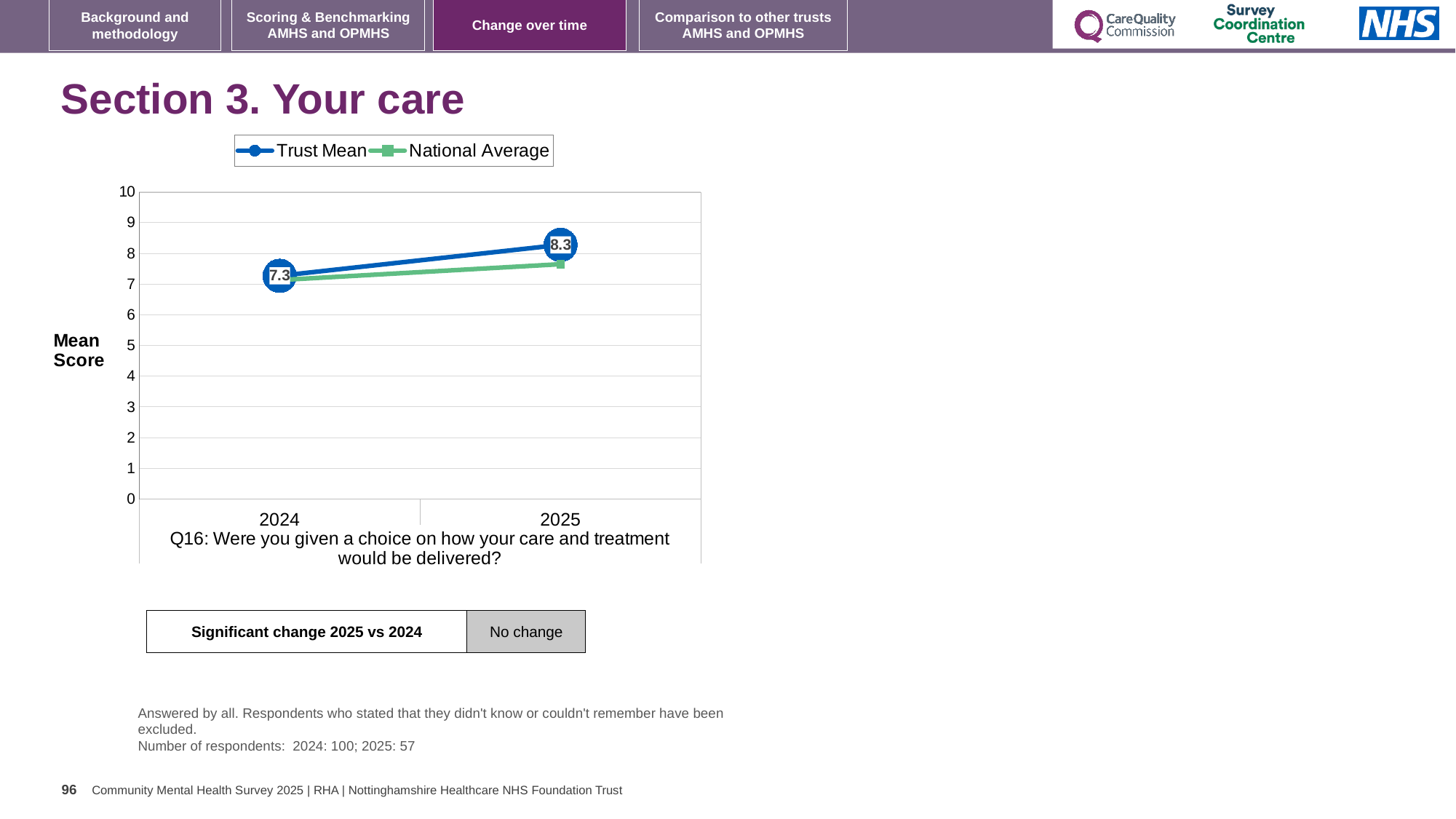
How many series does the legend list? 2 What is the label on the vertical axis of the chart? Mean Score What is the Trust Mean score for 2024? 7.3 How many years are plotted on the x axis? 2 Is the National Average value for 2025 greater or less than 7? greater Which year has the higher Trust Mean score, 2024 or 2025? 2025 What is the Trust Mean score for 2025? 8.3 Does the Trust Mean line rise or fall from 2024 to 2025? rises By how much did the Trust Mean score change from 2024 to 2025? 1.0 Is the National Average value for 2024 greater or less than 8? less What kind of chart is shown on the slide? line chart In 2025, which is higher, the Trust Mean or the National Average? Trust Mean